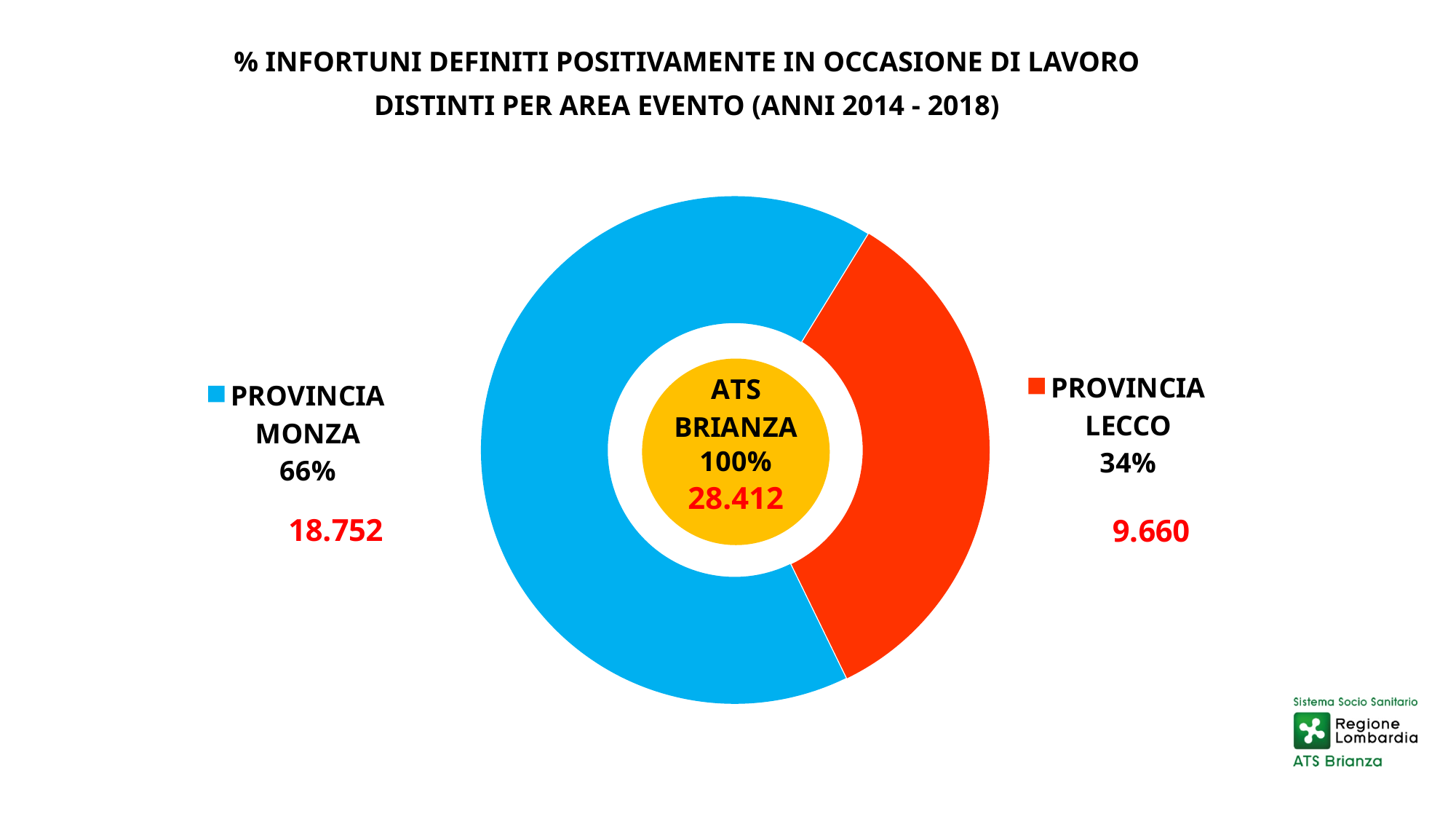
What is the value shown for PROVINCIA MONZA? 18.752 What kind of chart is shown on the slide? doughnut chart Which province has the smaller share of the pie chart? PROVINCIA LECCO Is the value for PROVINCIA MONZA larger or smaller than the value for PROVINCIA LECCO? larger What colour represents PROVINCIA LECCO in the chart? red What is the difference in percentage points between PROVINCIA MONZA and PROVINCIA LECCO? 32 What percentage share does PROVINCIA MONZA have in the pie chart? 66% How many categories are shown in the pie chart? 2 What total value is shown in the centre of the chart for ATS BRIANZA? 28.412 Which province has the larger share of the pie chart? PROVINCIA MONZA What percentage share does PROVINCIA LECCO have in the pie chart? 34% What is the value shown for PROVINCIA LECCO? 9.660